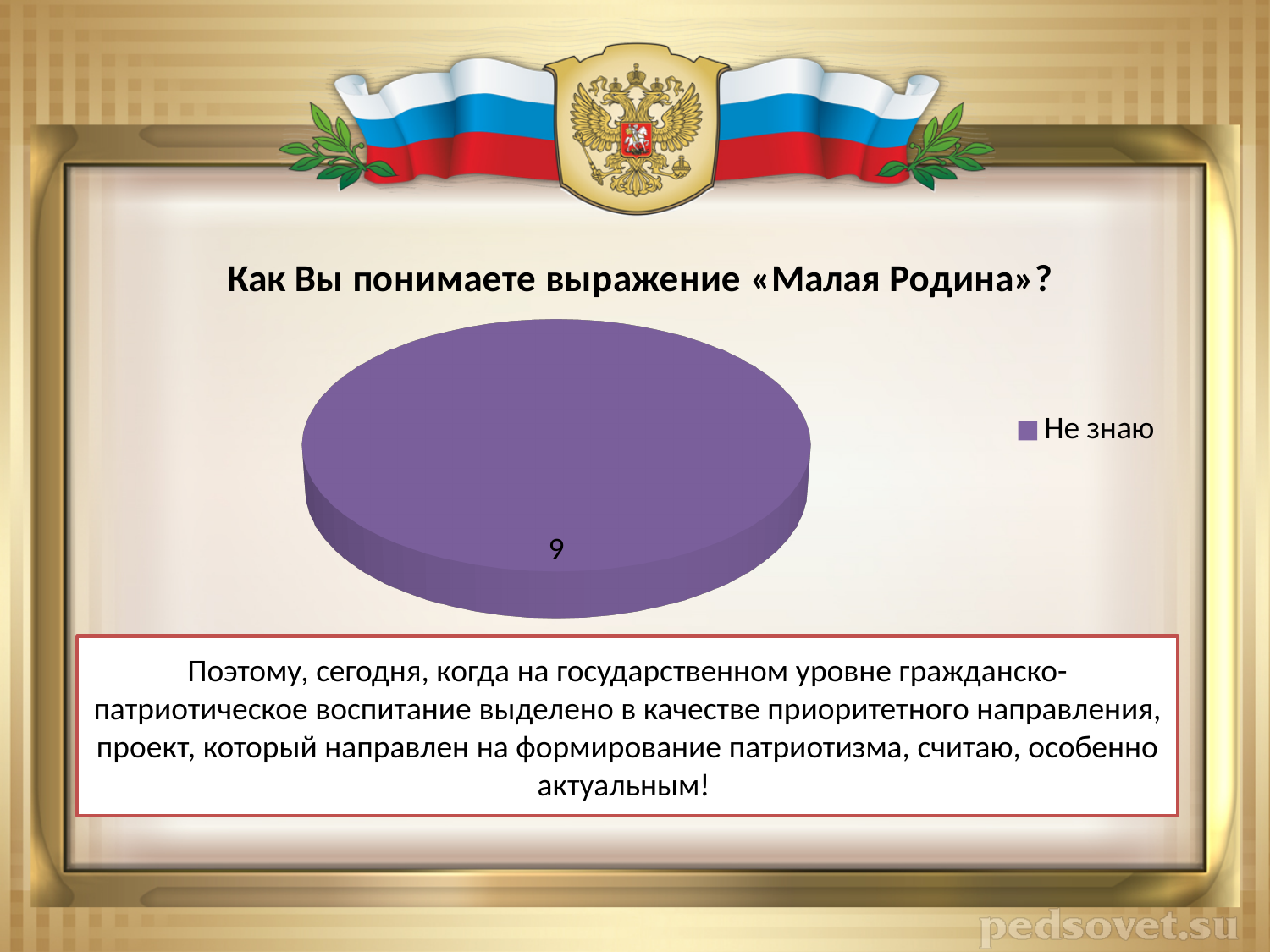
How many slices does the pie chart have? 1 What is the title of the chart? Как Вы понимаете выражение «Малая Родина»? What is the value shown for the "Не знаю" slice? 9 What share of the pie does the "Не знаю" slice take up? 100% What colour is the "Не знаю" slice? Purple Which category is the largest in the pie chart? Не знаю What kind of chart is shown on the slide? Pie chart How many entries does the legend list? 1 What is the total of all values in the pie chart? 9